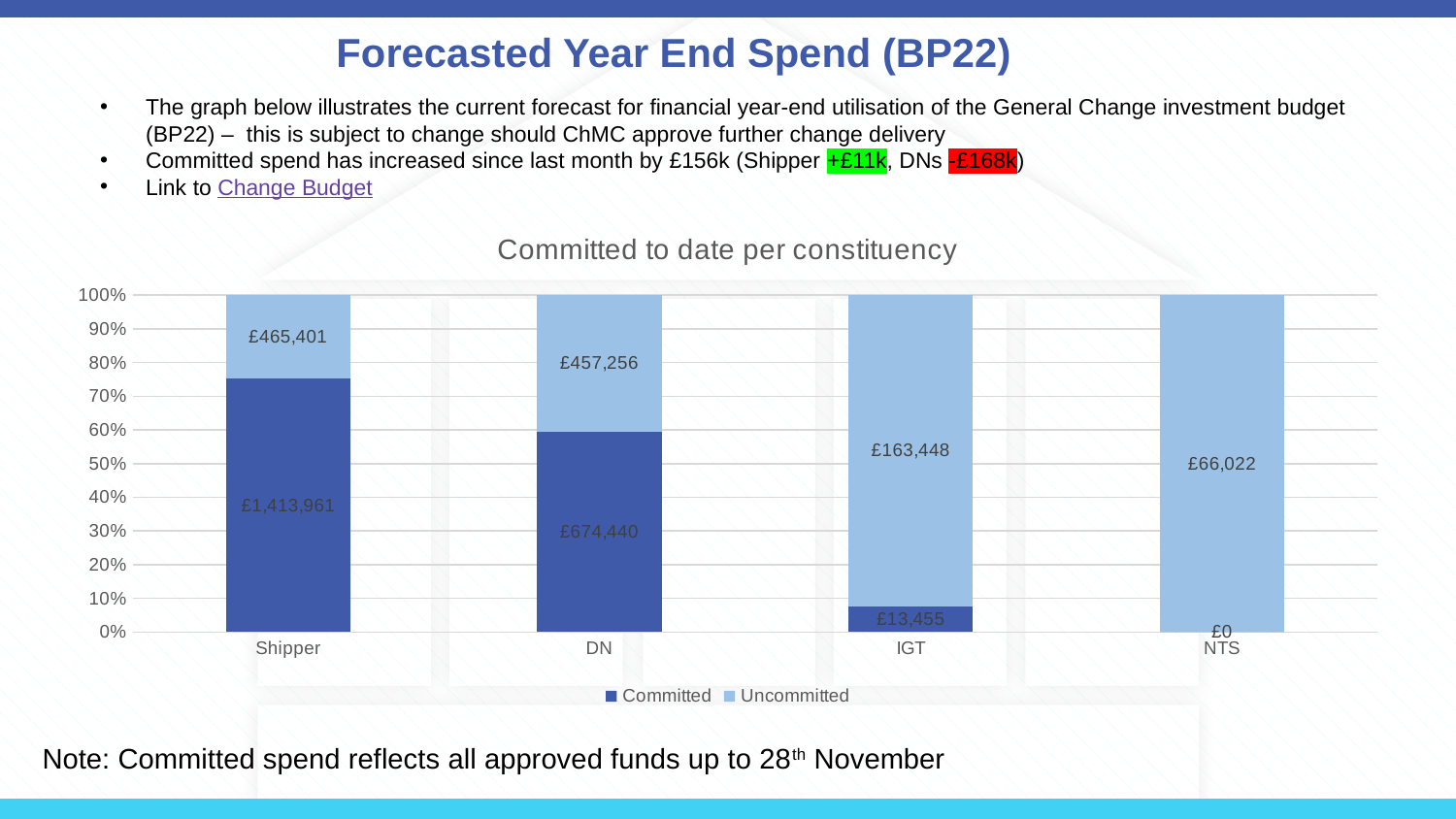
What is the Committed value for Shipper? £1,413,961 What is the total of the Committed and Uncommitted values for DN? £1,131,696 What is the Committed value for NTS? £0 What is the difference between the Committed values for Shipper and DN? £739,521 Which constituency has the lowest Uncommitted value? NTS Which constituency has the highest Committed value? Shipper Which is larger, the Uncommitted value for Shipper or the Uncommitted value for IGT? Shipper What is the Uncommitted value for DN? £457,256 How many constituencies are shown on the x axis? 4 Is the Committed share of the Shipper bar greater or less than 70%? greater How many series does the legend list? 2 What is the Committed value for IGT? £13,455